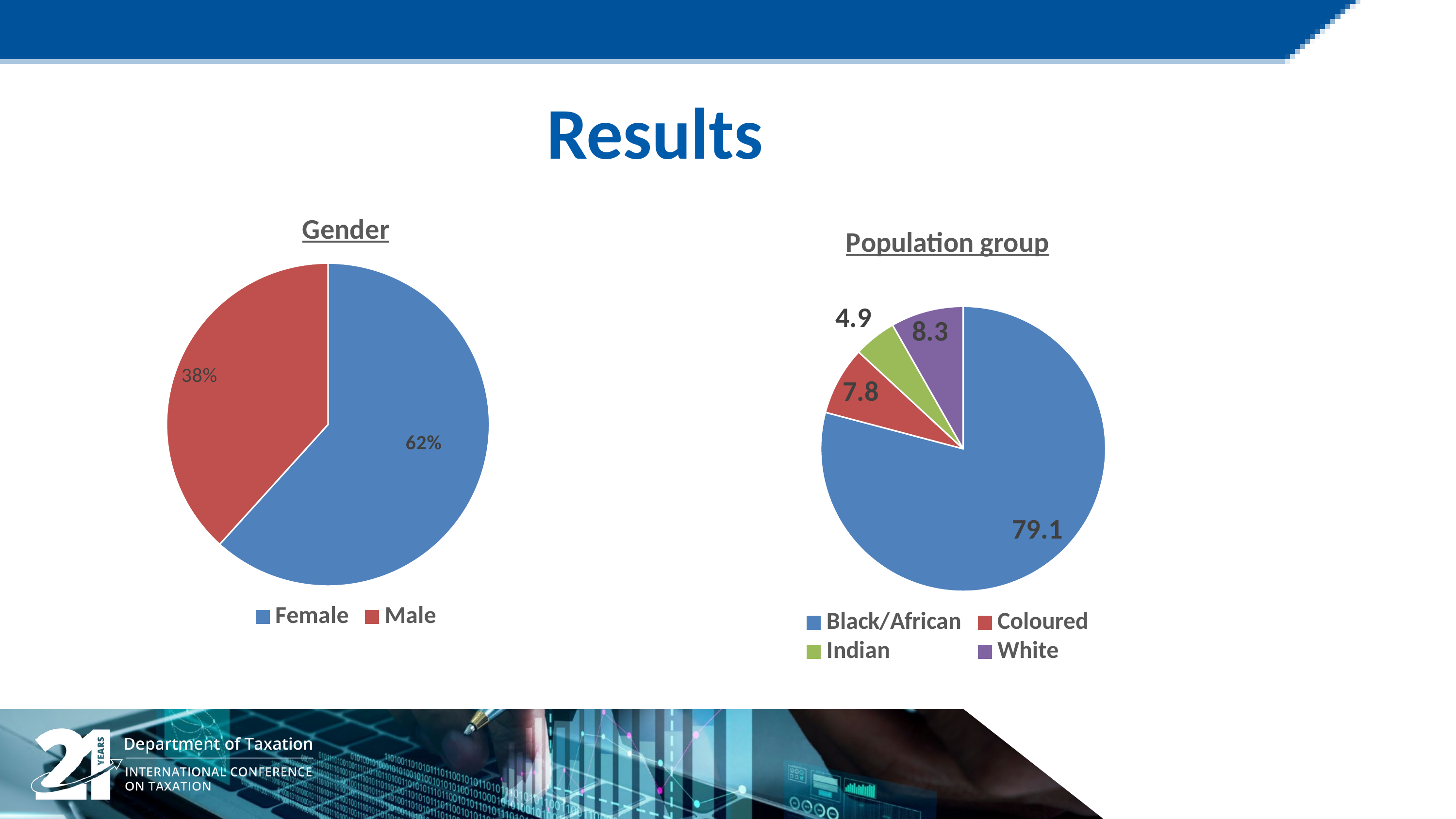
In the Population group chart, what is the value for White? 8.3 In the Gender chart, what is the value for Male? 38% In the Population group chart, what is the difference between the White and Coloured values? 0.5 In the Population group chart, how many population groups are shown? 4 In the Population group chart, which group has the smallest slice? Indian In the Population group chart, what is the value for Coloured? 7.8 In the Gender chart, what is the difference between the Female and Male shares? 24% In the Gender chart, what is the value for Female? 62% In the Population group chart, what is the value for Black/African? 79.1 What kind of chart is the Gender chart? Pie chart In the Gender chart, which is larger, Female or Male? Female In the Population group chart, what is the value for Indian? 4.9